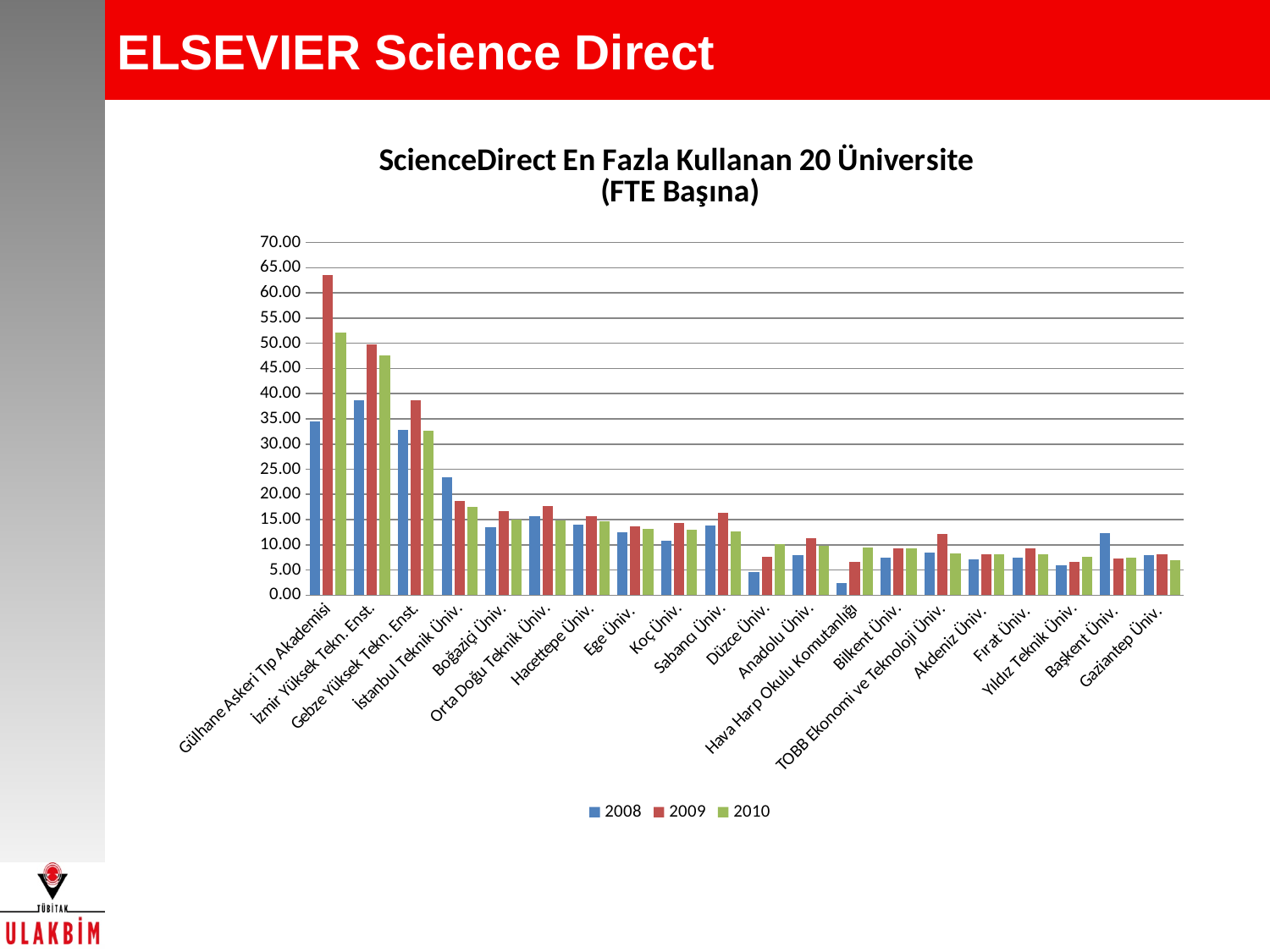
Which is larger for 2008: İzmir Yüksek Tekn. Enst. or Gülhane Askeri Tıp Akademisi? İzmir Yüksek Tekn. Enst. What kind of chart is shown on the slide? bar chart How many universities are shown on the x axis? 20 Which university has the lowest 2008 value? Hava Harp Okulu Komutanlığı Is the 2009 value for Gebze Yüksek Tekn. Enst. greater or less than 35.00? greater Is the 2009 value for Gülhane Askeri Tıp Akademisi greater or less than 60.00? greater For Düzce Üniv., which year has the larger value: 2008 or 2010? 2010 What are the legend entries of the chart? 2008, 2009, 2010 Which university has the highest 2009 value? Gülhane Askeri Tıp Akademisi Is the 2008 value for İstanbul Teknik Üniv. greater or less than 20.00? greater How many series does the legend list? 3 What is the title of the chart? ScienceDirect En Fazla Kullanan 20 Üniversite (FTE Başına)